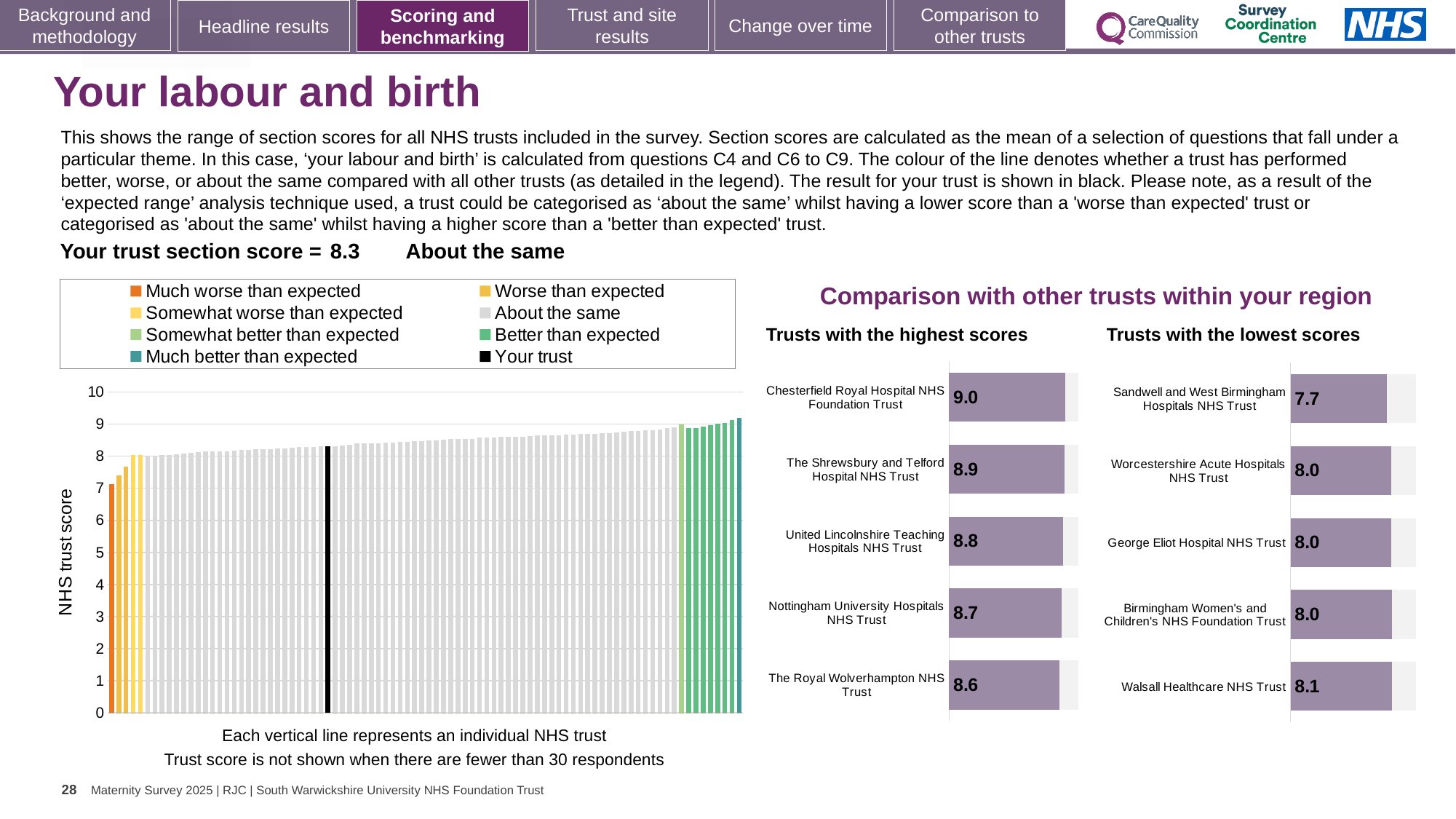
What kind of chart is the main chart with the y-axis labelled 'NHS trust score'? Bar chart Which has the higher score: United Lincolnshire Teaching Hospitals NHS Trust in the highest-scores chart or Walsall Healthcare NHS Trust in the lowest-scores chart? United Lincolnshire Teaching Hospitals NHS Trust In the 'Trusts with the lowest scores' chart, which trust has the highest score? Walsall Healthcare NHS Trust In the 'Trusts with the highest scores' chart, what is the score for The Royal Wolverhampton NHS Trust? 8.6 In the 'Trusts with the lowest scores' chart, what is the score for Sandwell and West Birmingham Hospitals NHS Trust? 7.7 In the 'Trusts with the highest scores' chart, what is the score for Chesterfield Royal Hospital NHS Foundation Trust? 9.0 How many entries does the legend of the main 'NHS trust score' chart list? 8 In the main 'NHS trust score' chart, is the value of the leftmost (orange) bar greater or less than 8? less In the 'Trusts with the highest scores' chart, what is the difference between the scores of Chesterfield Royal Hospital NHS Foundation Trust and The Royal Wolverhampton NHS Trust? 0.4 In the 'Trusts with the lowest scores' chart, which trust has the lowest score? Sandwell and West Birmingham Hospitals NHS Trust In the main 'NHS trust score' chart, do the bar values rise or fall from left to right? Rise How many trusts are shown in the 'Trusts with the highest scores' chart? 5